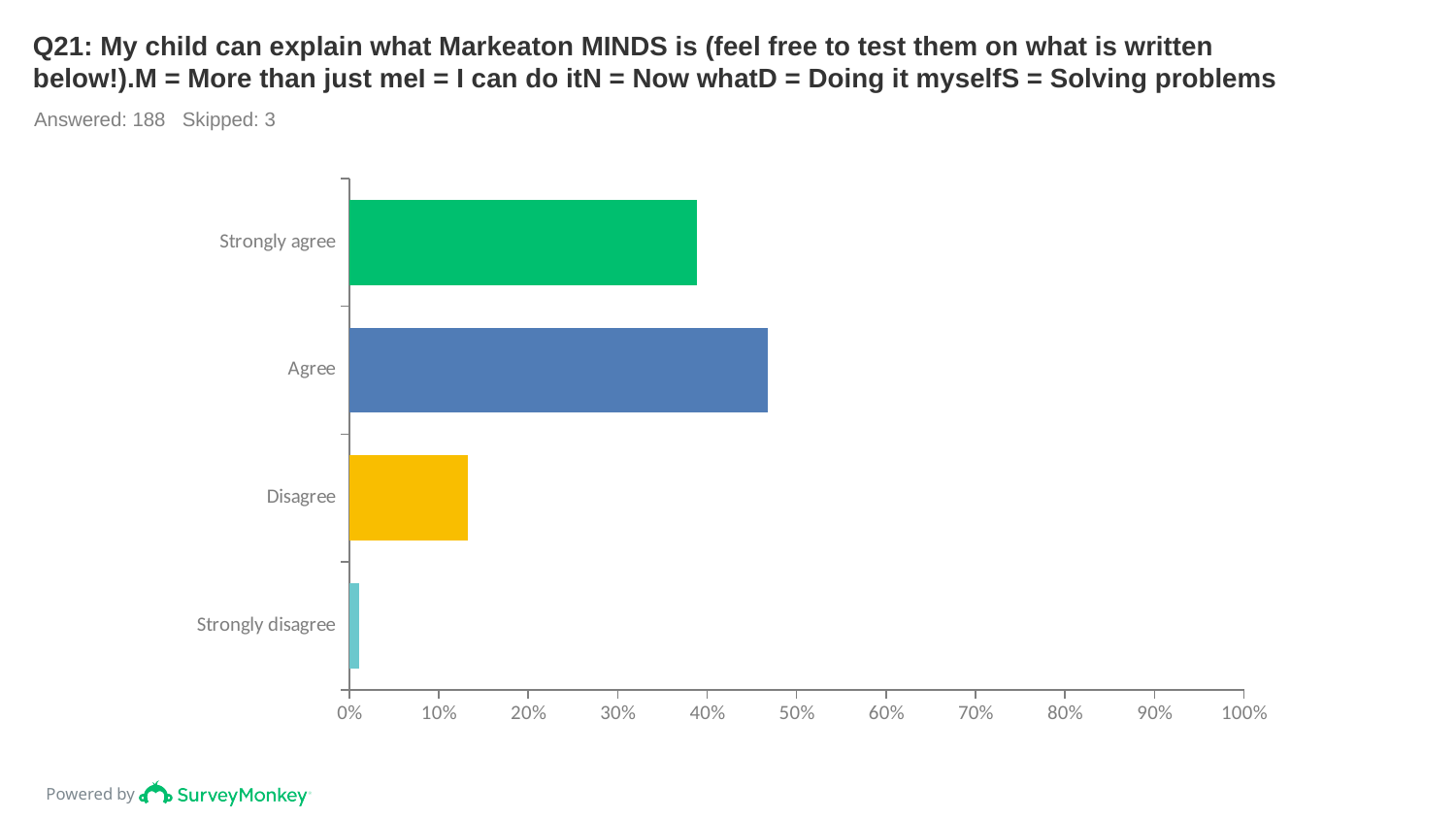
How many categories are shown on the chart? 4 Is the value for Agree greater or less than 40%? greater Which category has the highest value? Agree Is the value for Strongly disagree greater or less than 10%? less Which is larger, the value for Agree or the value for Strongly agree? Agree Which category has the lowest value? Strongly disagree How many respondents answered this question according to the slide? 188 Is the value for Strongly agree greater or less than 50%? less What kind of chart is shown on the slide? bar chart What is the maximum value shown on the x axis? 100% Which is larger, the value for Strongly agree or the value for Disagree? Strongly agree